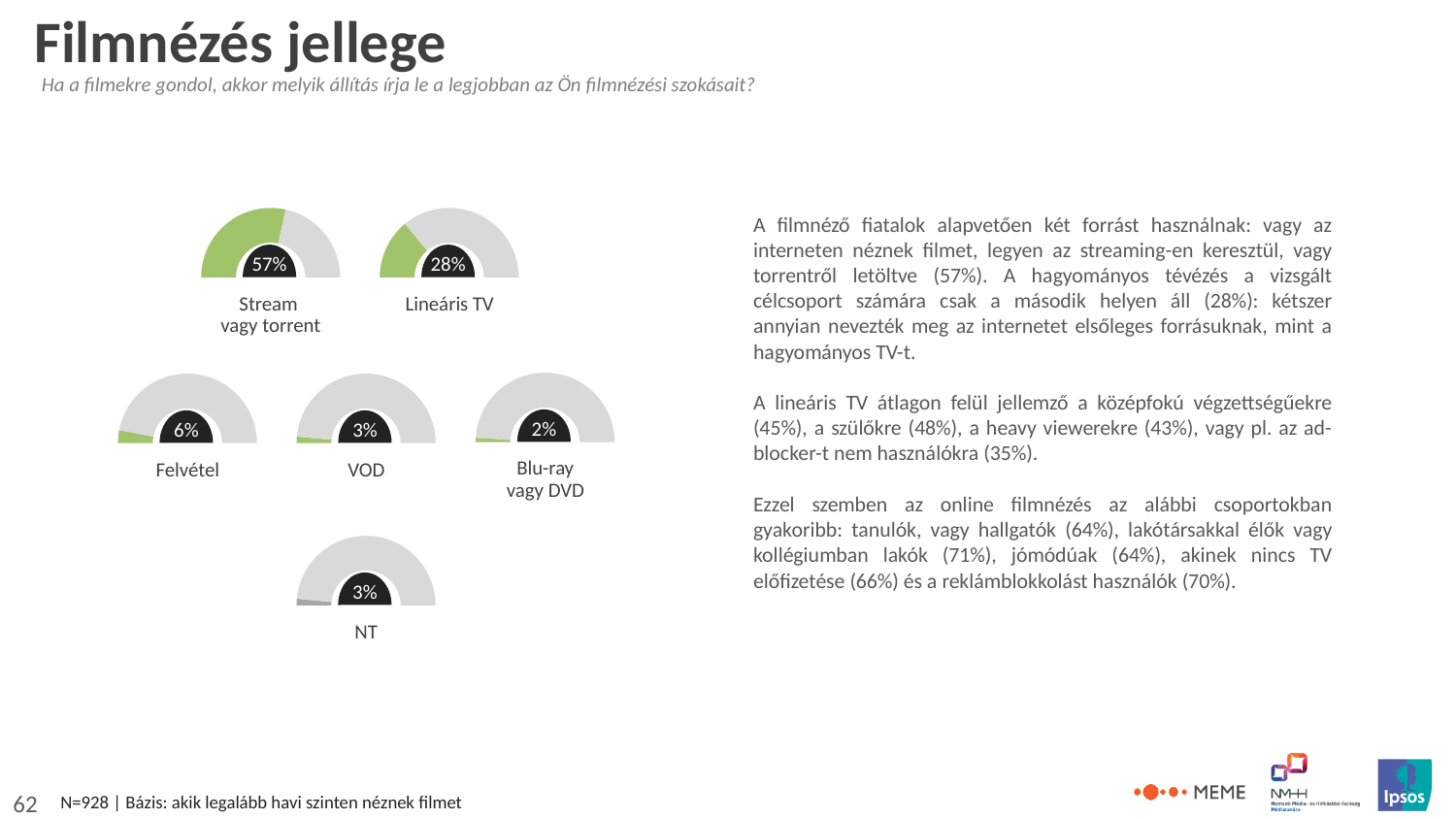
What percentage is shown for 'Lineáris TV'? 28% What percentage is shown for 'VOD'? 3% What kind of chart is used to display the values? Semicircular doughnut (gauge) chart Which category has the lowest percentage? Blu-ray vagy DVD What is the difference in percentage points between 'Stream vagy torrent' and 'Lineáris TV'? 29 What percentage is shown for 'NT'? 3% What percentage is shown for 'Felvétel'? 6% What percentage is shown for 'Stream vagy torrent'? 57% How many categories (gauges) are shown on the slide? 6 Which category has the highest percentage? Stream vagy torrent Which is larger, the value for 'Felvétel' or the value for 'VOD'? Felvétel What percentage is shown for 'Blu-ray vagy DVD'? 2%